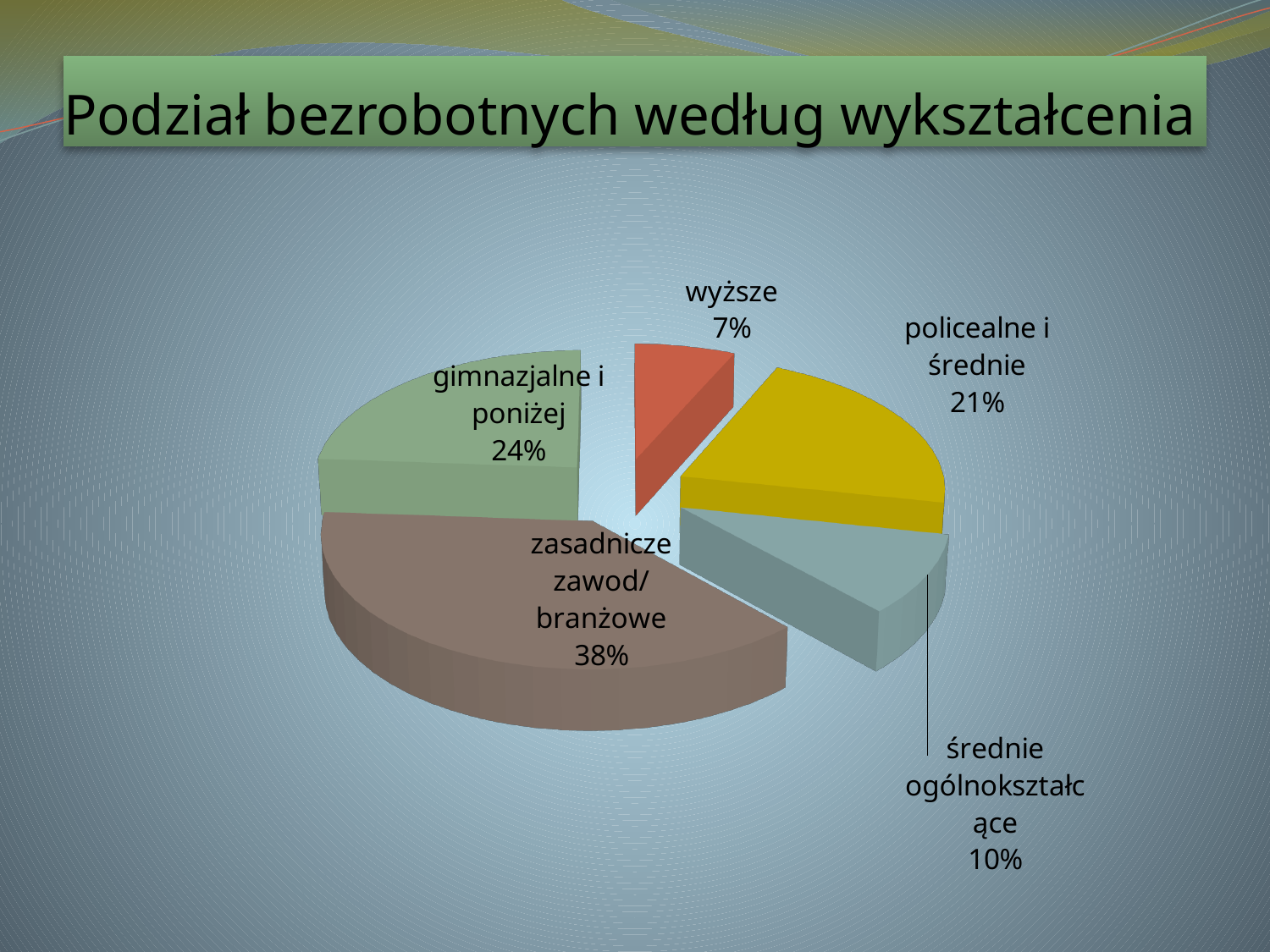
How many categories are shown in the pie chart? 5 What is the value shown for 'wyższe'? 7% What is the value shown for 'policealne i średnie'? 21% What is the value shown for 'gimnazjalne i poniżej'? 24% What is the title of the slide? Podział bezrobotnych według wykształcenia What share of the pie does the 'zasadnicze zawod/branżowe' slice represent? 38% What is the difference between the shares of 'zasadnicze zawod/branżowe' and 'gimnazjalne i poniżej'? 14% Which is larger, the share for 'policealne i średnie' or for 'średnie ogólnokształcące'? policealne i średnie Which category has the largest share? zasadnicze zawod/branżowe What kind of chart is shown on the slide? pie chart What is the value shown for 'średnie ogólnokształcące'? 10% Which category has the smallest share? wyższe